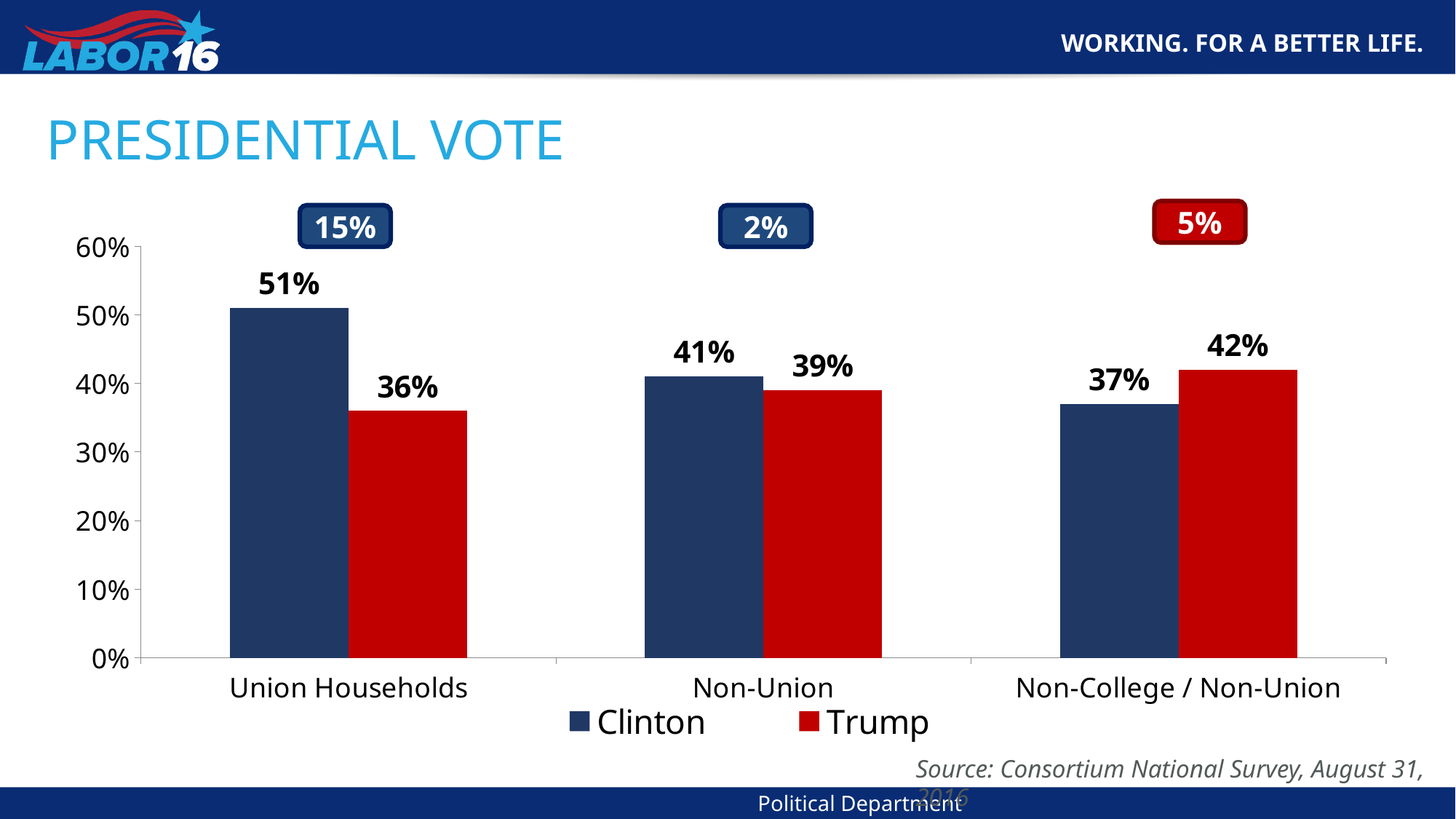
What is the value for Clinton in the Non-Union category? 41% Which category has the highest Clinton value? Union Households How many categories are shown on the x axis? 3 Which is larger in the Non-College / Non-Union category, Clinton or Trump? Trump What is the value for Trump in the Non-College / Non-Union category? 42% What is the difference between Clinton and Trump among Union Households? 15% How many series does the legend list? 2 What kind of chart is shown on the slide? Bar chart Is the value for Trump in the Non-Union category greater or less than 30%? greater Which category has the lowest Trump value? Union Households What is the value for Trump among Union Households? 36% What is the value for Clinton among Union Households? 51%